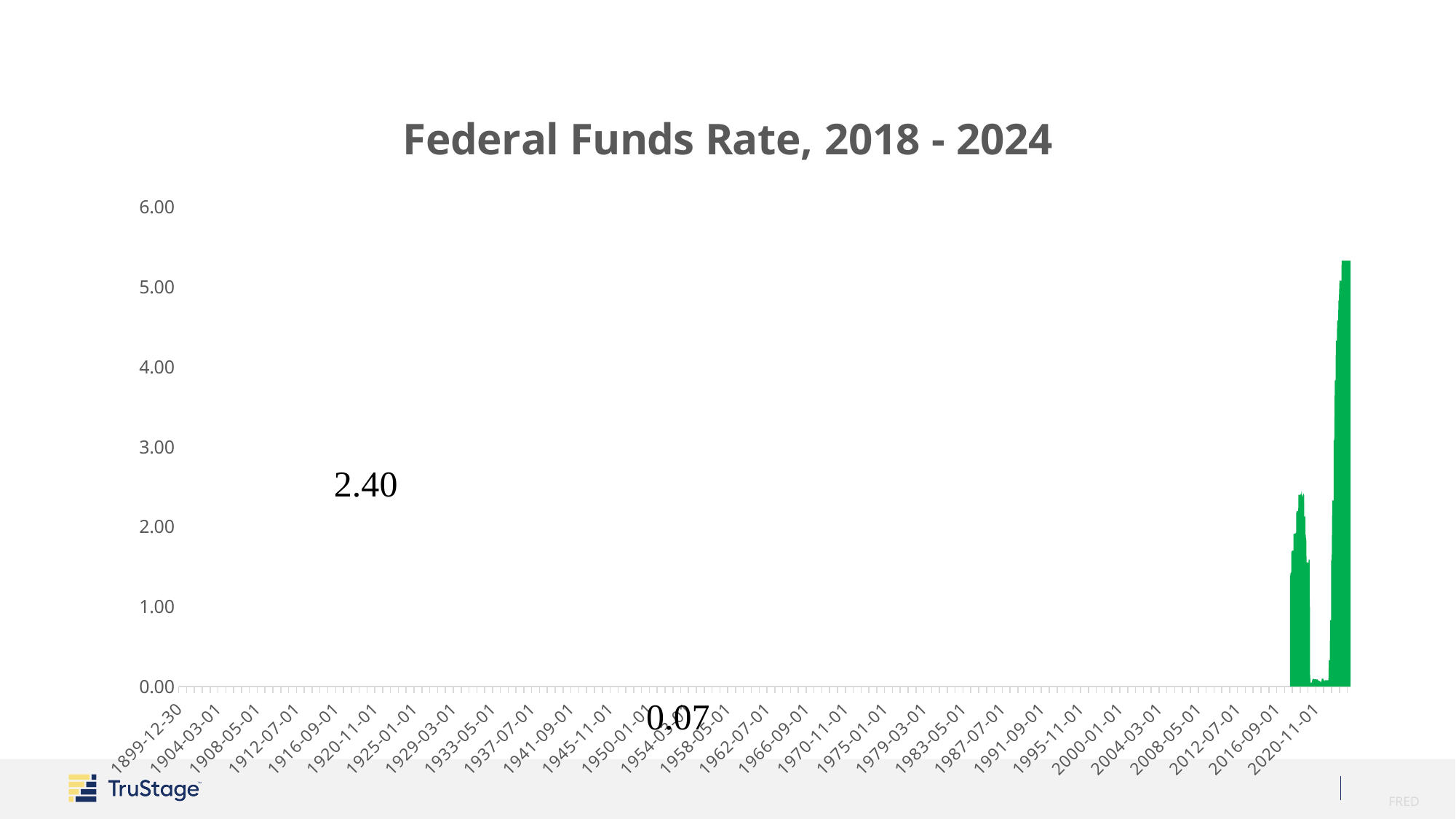
Is the highest value reached by the plotted series greater or less than 5.00? greater What is the highest tick value shown on the vertical axis? 6.00 Is the earlier, smaller peak of the series (before the dip to near zero) greater or less than 3.00? less Is the earlier, smaller peak of the series (before the dip to near zero) greater or less than 2.00? greater Which of the two peaks in the series is larger, the earlier one or the one at the right end? the one at the right end What kind of chart is shown on the slide? bar chart What number is written in the text annotation on the left side of the plot area? 2.40 From the low point near zero to the right end of the series, do the values rise or fall? rise What is the title of the chart? Federal Funds Rate, 2018 - 2024